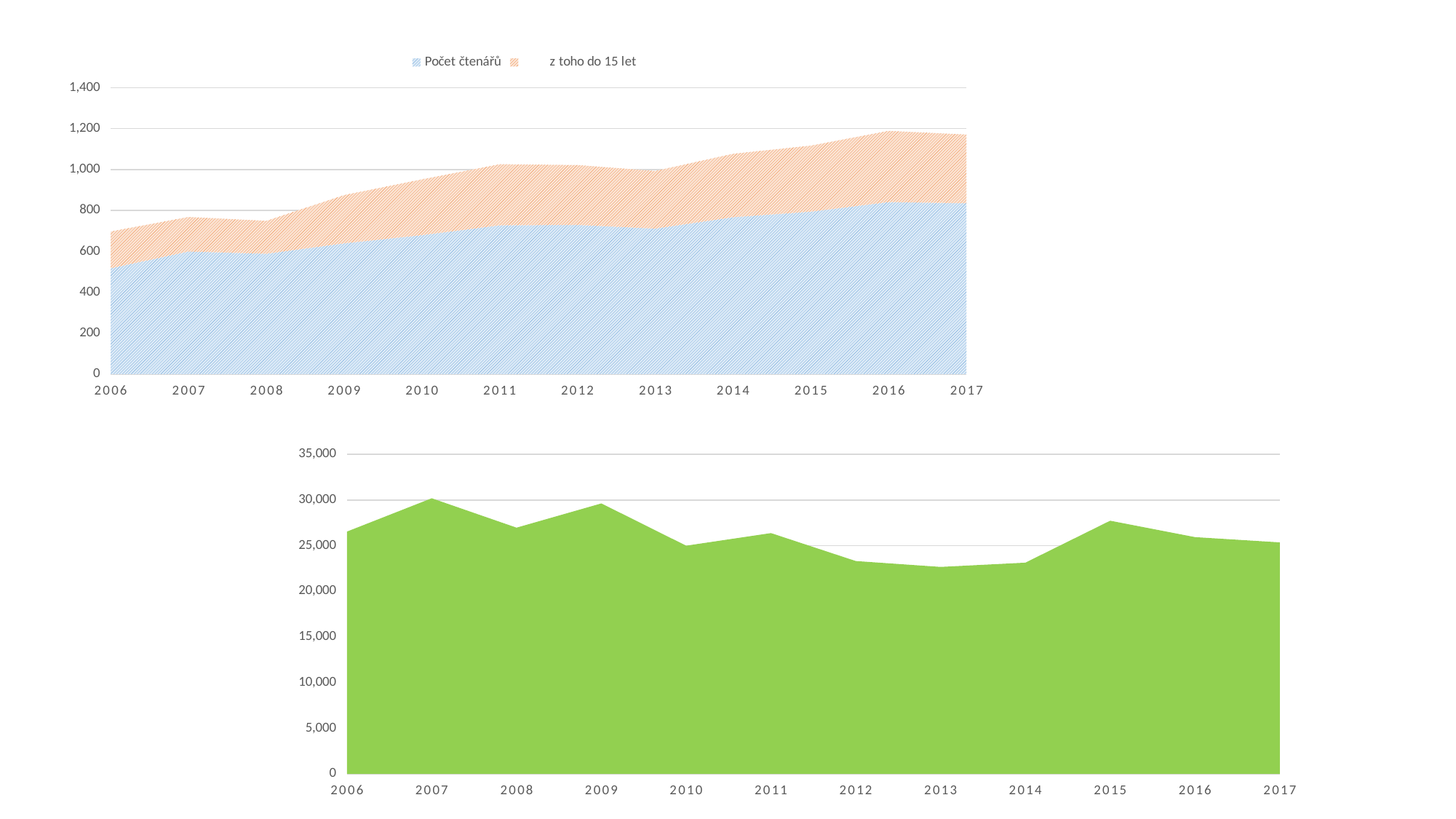
In the bottom chart, is the value for 2015 greater or less than 25,000? greater How many series does the legend of the top chart list? 2 In the bottom chart, which is larger, the value for 2007 or the value for 2013? 2007 In the top chart, is the stacked total for 2006 greater or less than 800? less In the top chart, is the value for Počet čtenářů in 2006 greater or less than 600? less How many years are shown on the x axis of the bottom chart? 12 What kind of chart is the bottom chart on the slide? area chart In the top chart, does the Počet čtenářů series generally rise or fall from 2006 to 2017? rise What are the two series named in the legend of the top chart? Počet čtenářů and z toho do 15 let What kind of chart is the top chart on the slide? area chart